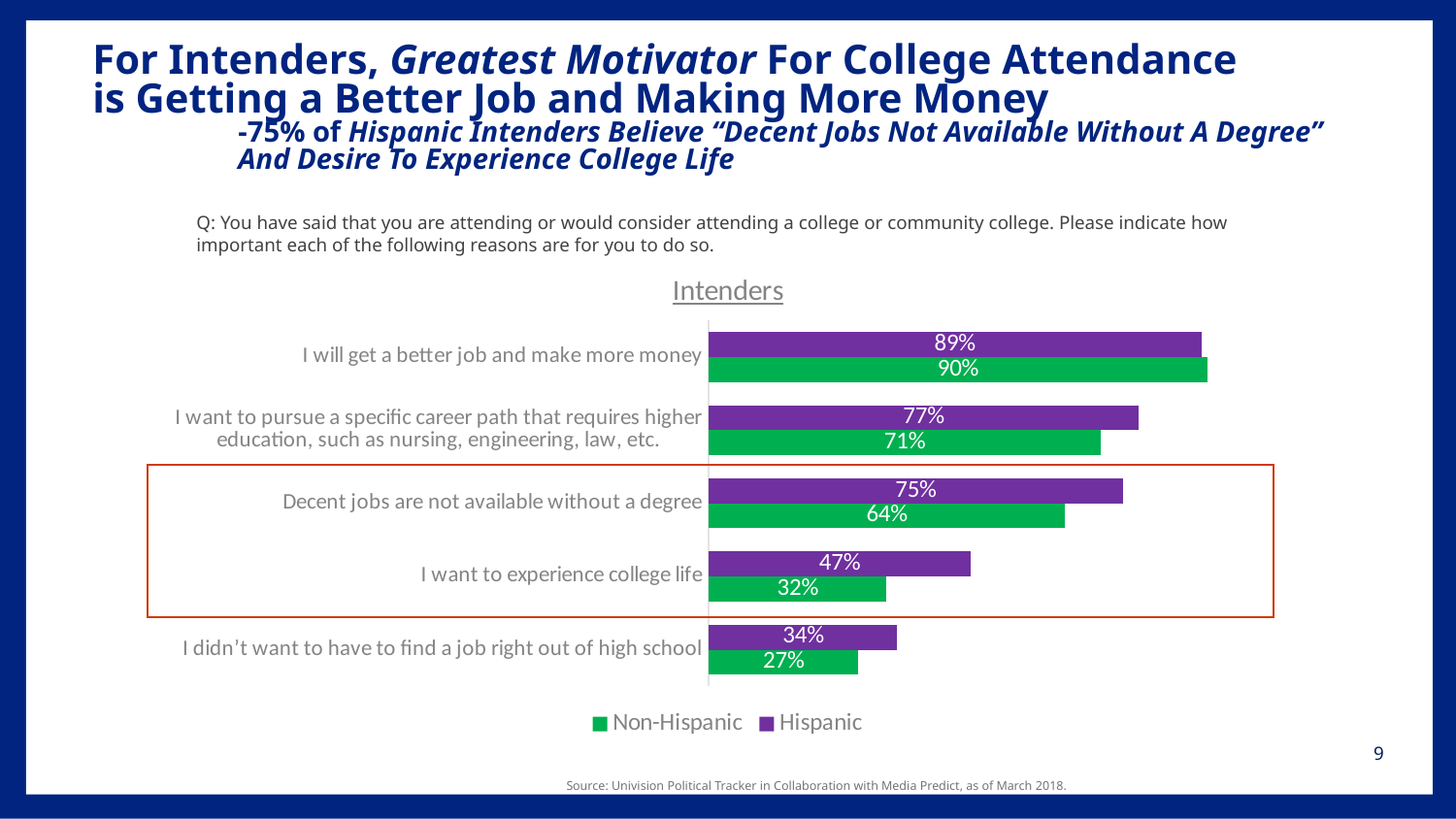
What is the difference between the Hispanic and Non-Hispanic values for "Decent jobs are not available without a degree"? 11% What is the difference between the Hispanic and Non-Hispanic values for "I want to experience college life"? 15% What percentage of Hispanic intenders said "I will get a better job and make more money"? 89% What type of chart is shown on the slide? Bar chart What is the Non-Hispanic value for "Decent jobs are not available without a degree"? 64% How many reasons (categories) are shown in the chart? 5 For "I want to pursue a specific career path that requires higher education", which group has the larger value, Hispanic or Non-Hispanic? Hispanic Which colour represents the Hispanic series in the chart? Purple What is the Hispanic value for "I want to experience college life"? 47% Which reason has the lowest Hispanic value? I didn't want to have to find a job right out of high school How many series does the legend list? 2 Which reason has the highest Non-Hispanic value? I will get a better job and make more money